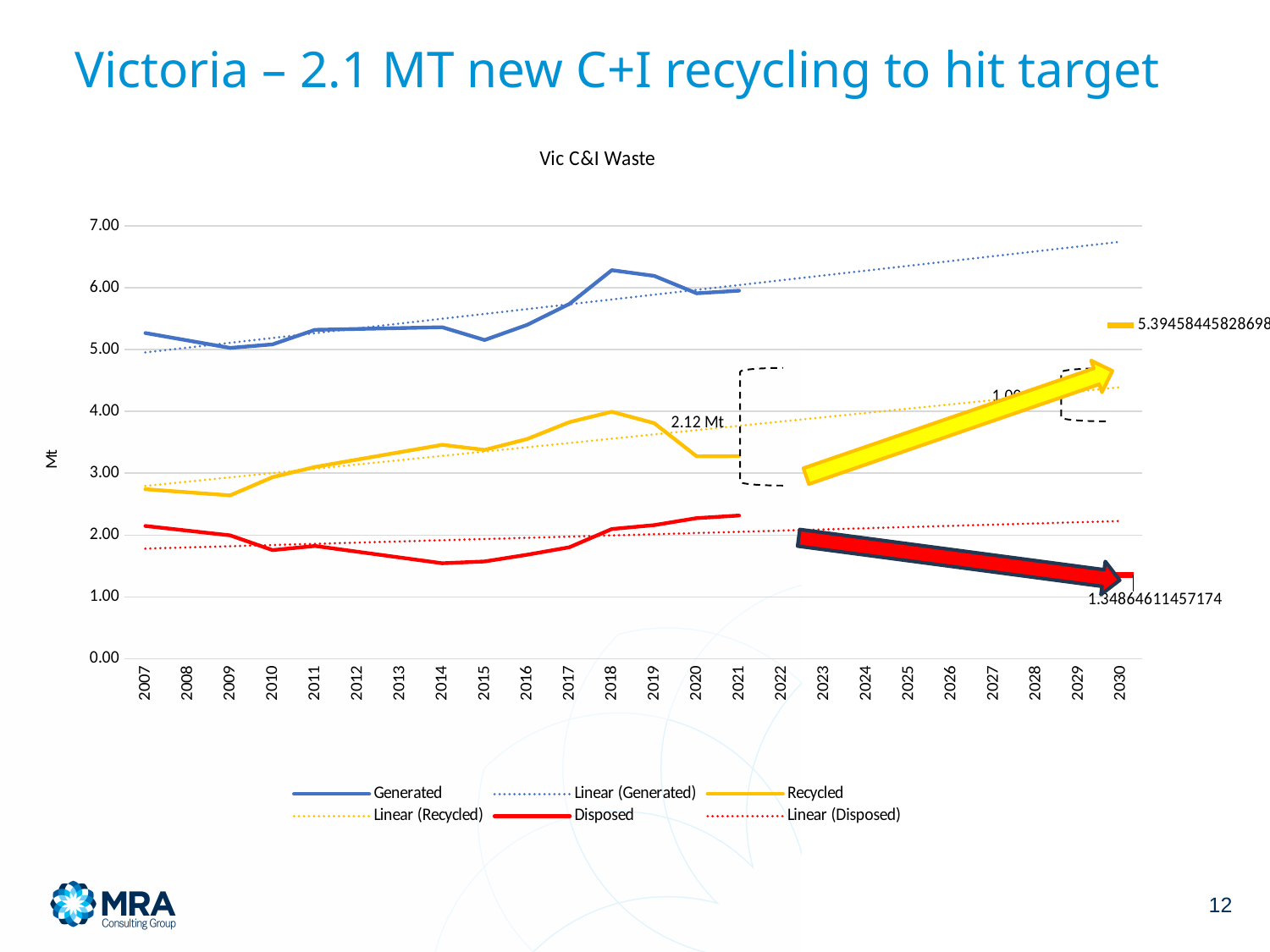
Is the value for Generated in 2018 greater or less than 6.00? greater What value is printed as the data label at the end of the red (Disposed) line in 2030? 1.34864611457174 What kind of chart is shown on the slide? Line chart In 2018, which is larger: the Generated value or the Recycled value? Generated What is the label on the vertical axis of the chart? Mt What value is printed as the data label at the end of the yellow (Recycled) line in 2030? 5.39458445828698 Which series has the highest values across the chart? Generated Is the value for Recycled in 2009 greater or less than 3.00? less Does the Linear (Generated) trendline rise or fall from 2007 to 2030? Rise How many series does the chart legend list? 6 What is the title of the chart? Vic C&I Waste Is the value for Disposed in 2014 greater or less than 2.00? less